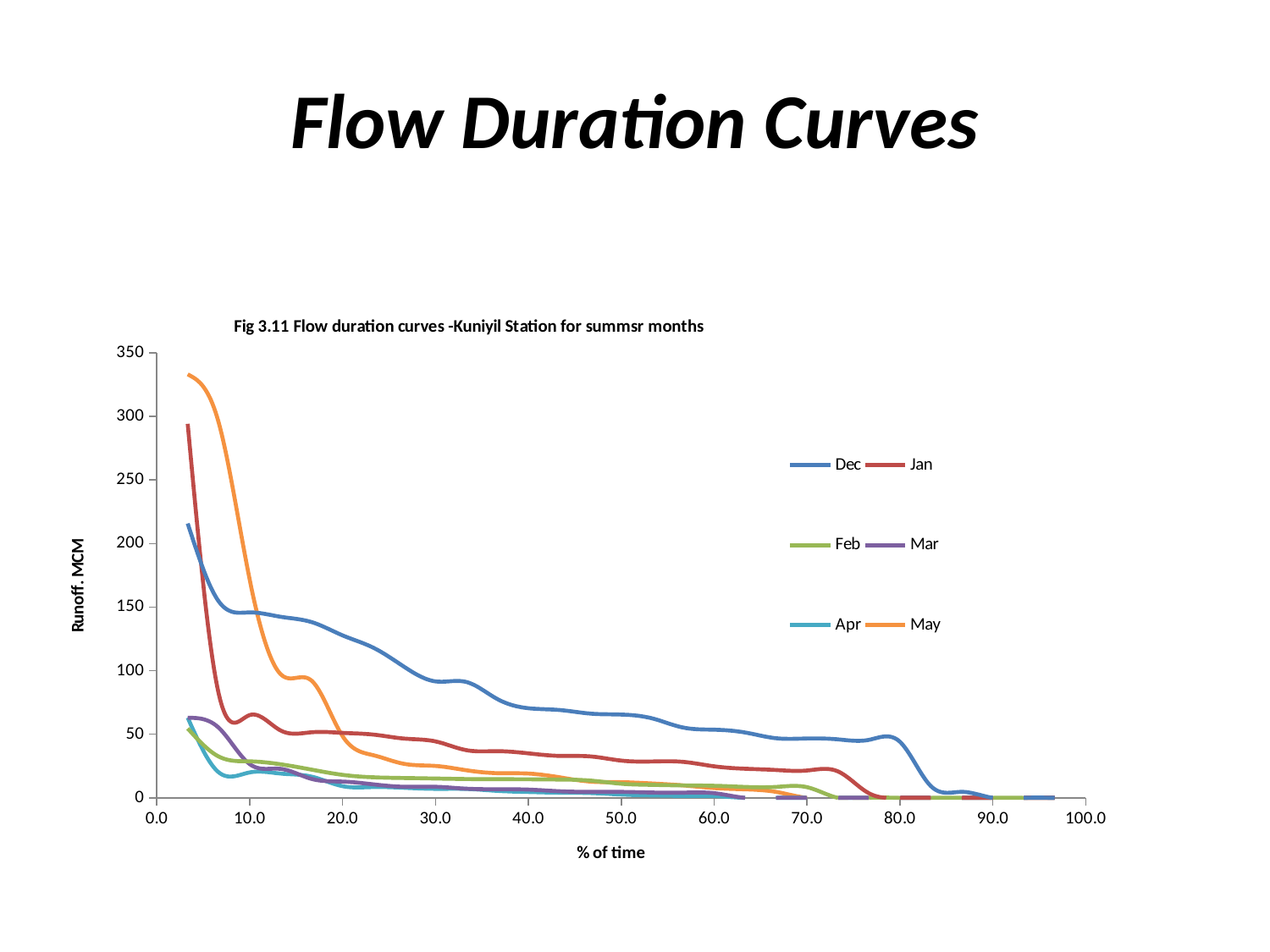
What is the label of the vertical axis? Runoff. MCM Is the value for Dec at 30.0% of time greater or less than 100? less Is the value for Mar at 10.0% of time greater or less than 50? less Which series has the highest runoff at the left end of the chart (lowest % of time)? May What is the title of the chart? Fig 3.11 Flow duration curves -Kuniyil Station for summsr months At 20.0% of time, which series has the higher runoff, Dec or Jan? Dec Is the value for Dec at 20.0% of time greater or less than 100? greater Does the Dec curve rise or fall as % of time increases? fall How many series does the legend list? 6 What kind of chart is shown on the slide? line chart